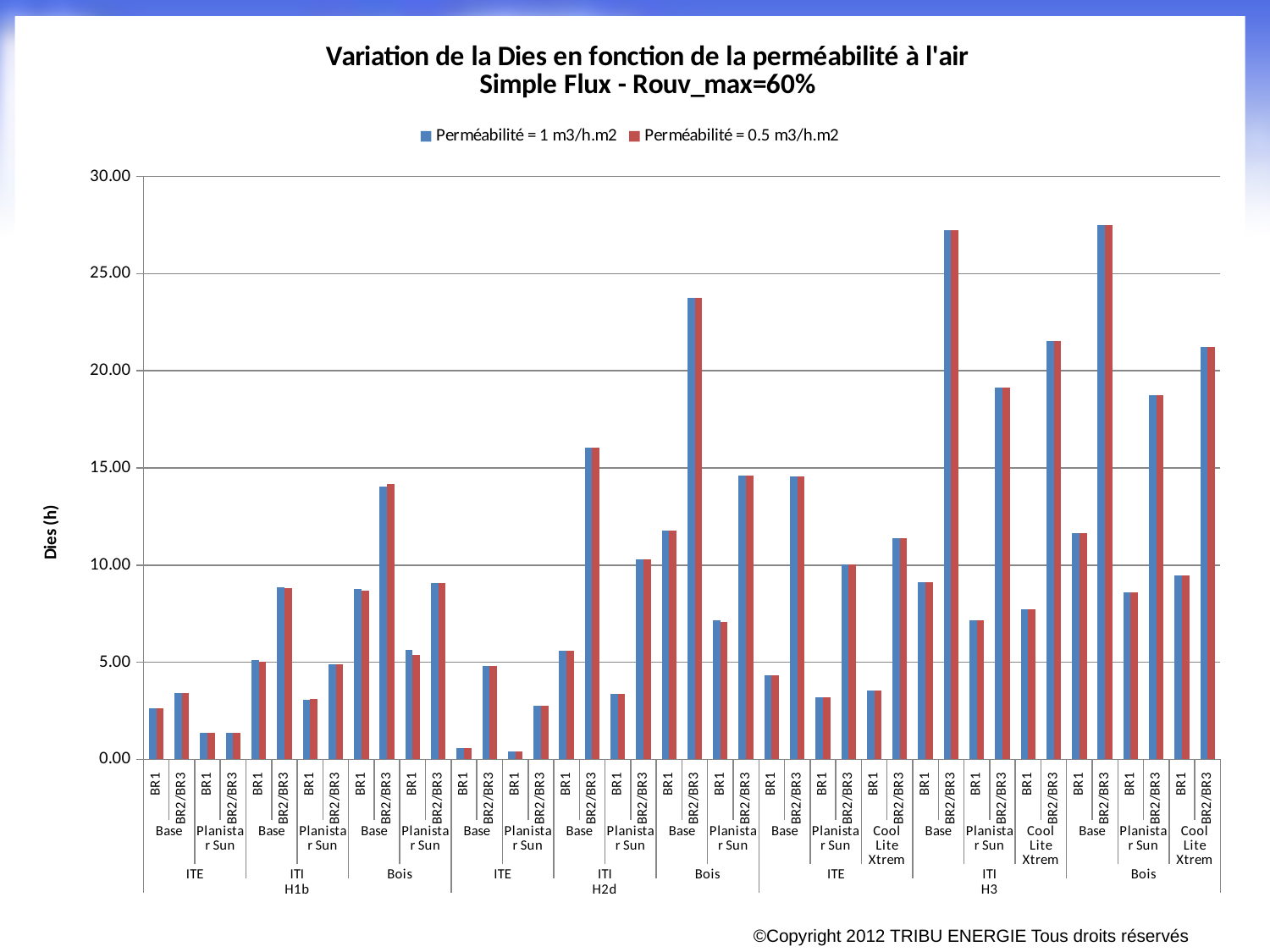
What is the second legend entry? Perméabilité = 0.5 m3/h.m2 How many series does the legend list? 2 How many bars are plotted for the Perméabilité = 1 m3/h.m2 series in the H3 group? 18 Is the value for H2d, Bois, Base, BR2/BR3 (Perméabilité = 1 m3/h.m2) greater or less than 20.00? greater Is the value for H1b, Bois, Base, BR2/BR3 (Perméabilité = 1 m3/h.m2) greater or less than 15.00? less What is the label of the vertical axis? Dies (h) Which is larger for Perméabilité = 1 m3/h.m2: the Bois, Base, BR2/BR3 value in H2d or the Bois, Base, BR2/BR3 value in H1b? H2d What kind of chart is shown on the slide? Bar chart Is the value for H3, ITI, Base, BR2/BR3 (Perméabilité = 0.5 m3/h.m2) greater or less than 25.00? greater Which is larger for Perméabilité = 0.5 m3/h.m2 in H3: Planistar Sun BR2/BR3 under ITI or Planistar Sun BR2/BR3 under ITE? ITI